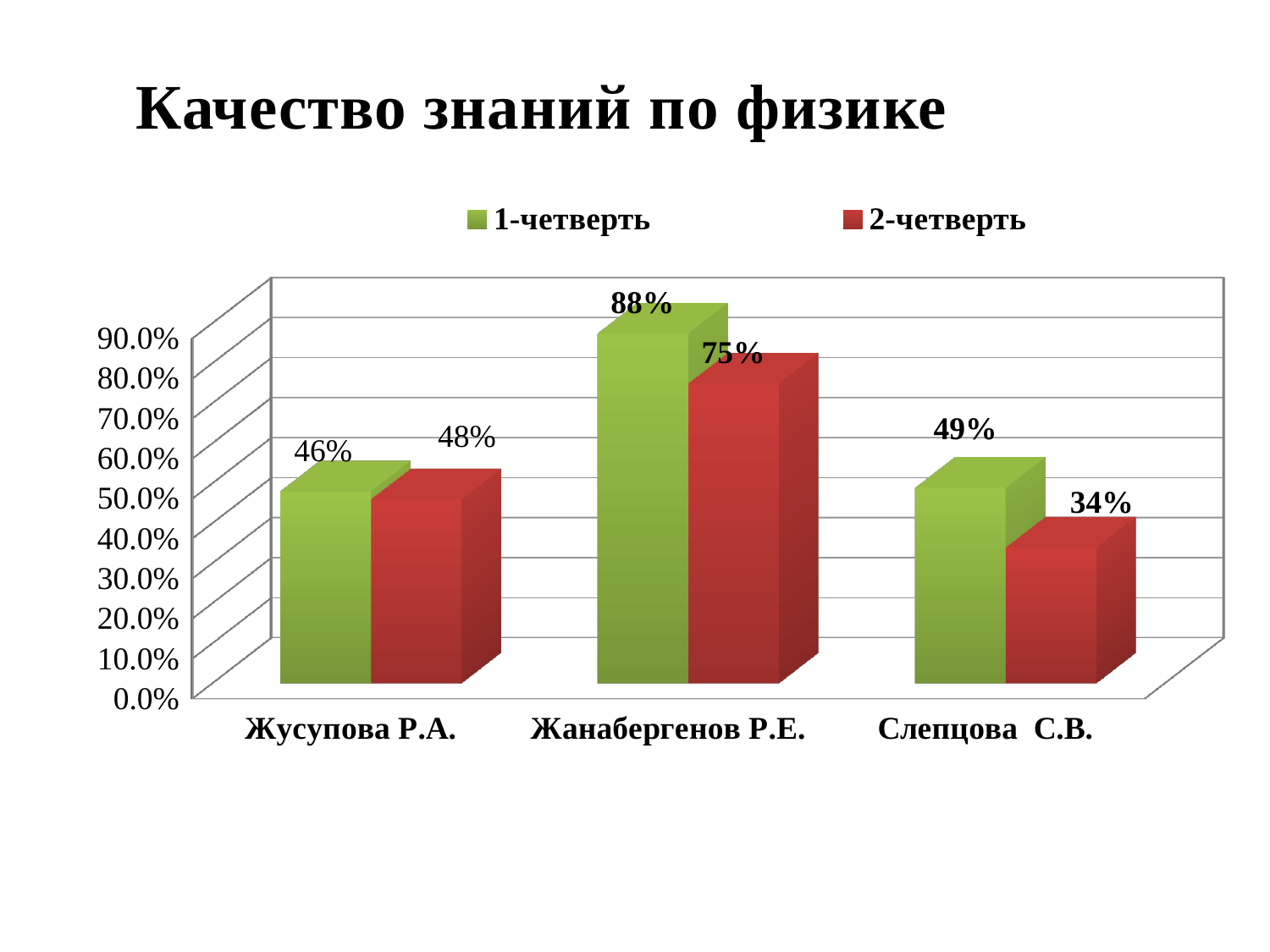
What kind of chart is shown on the slide? Bar chart What is the title of the slide? Качество знаний по физике What is the difference between the 1-четверть and 2-четверть values for Слепцова С.В.? 15% What is the value for Жусупова Р.А. in the 1-четверть series? 46% How many series does the legend list? 2 Which category has the lowest value in the 2-четверть series? Слепцова С.В. What is the difference between the 1-четверть and 2-четверть values for Жанабергенов Р.Е.? 13% Which category has the highest value in the 1-четверть series? Жанабергенов Р.Е. What is the value for Слепцова С.В. in the 1-четверть series? 49% How many categories are shown on the x axis? 3 What is the value for Жанабергенов Р.Е. in the 2-четверть series? 75%